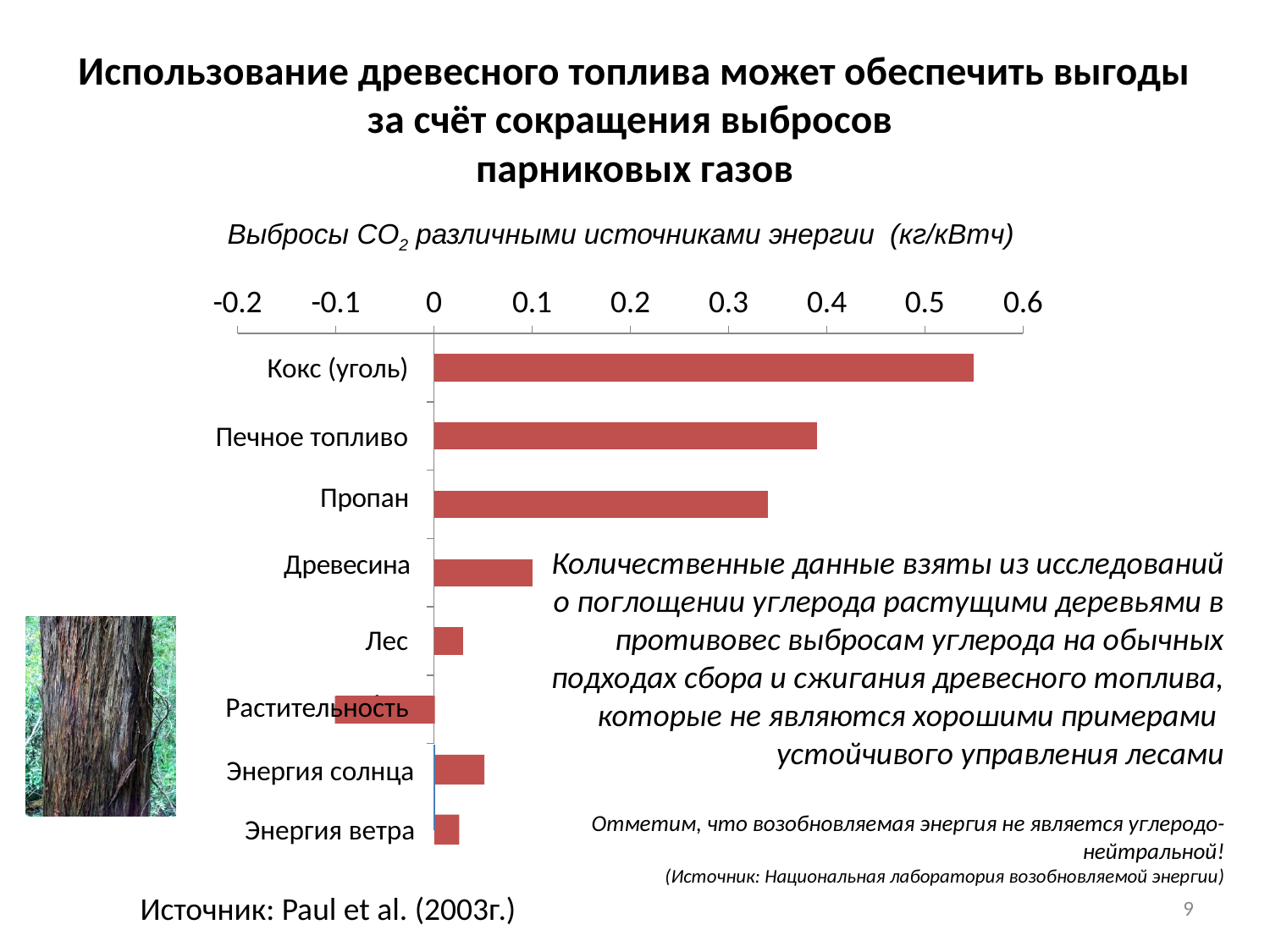
Which energy source has the lowest value in the chart? Растительность Is the value for Кокс (уголь) greater or less than 0.5? greater Which has the larger value, Энергия солнца or Энергия ветра? Энергия солнца Is the value for Печное топливо greater or less than 0.3? greater What is the title of the chart? Выбросы CO2 различными источниками энергии (кг/кВтч) In what units are the CO2 emissions in the chart expressed? кг/кВтч Which energy source has the highest CO2 emissions in the chart? Кокс (уголь) Is the value for Пропан greater or less than 0.3? greater What kind of chart is shown on the slide? bar chart How many energy sources (categories) are plotted in the chart? 8 Which has the larger value, Печное топливо or Пропан? Печное топливо